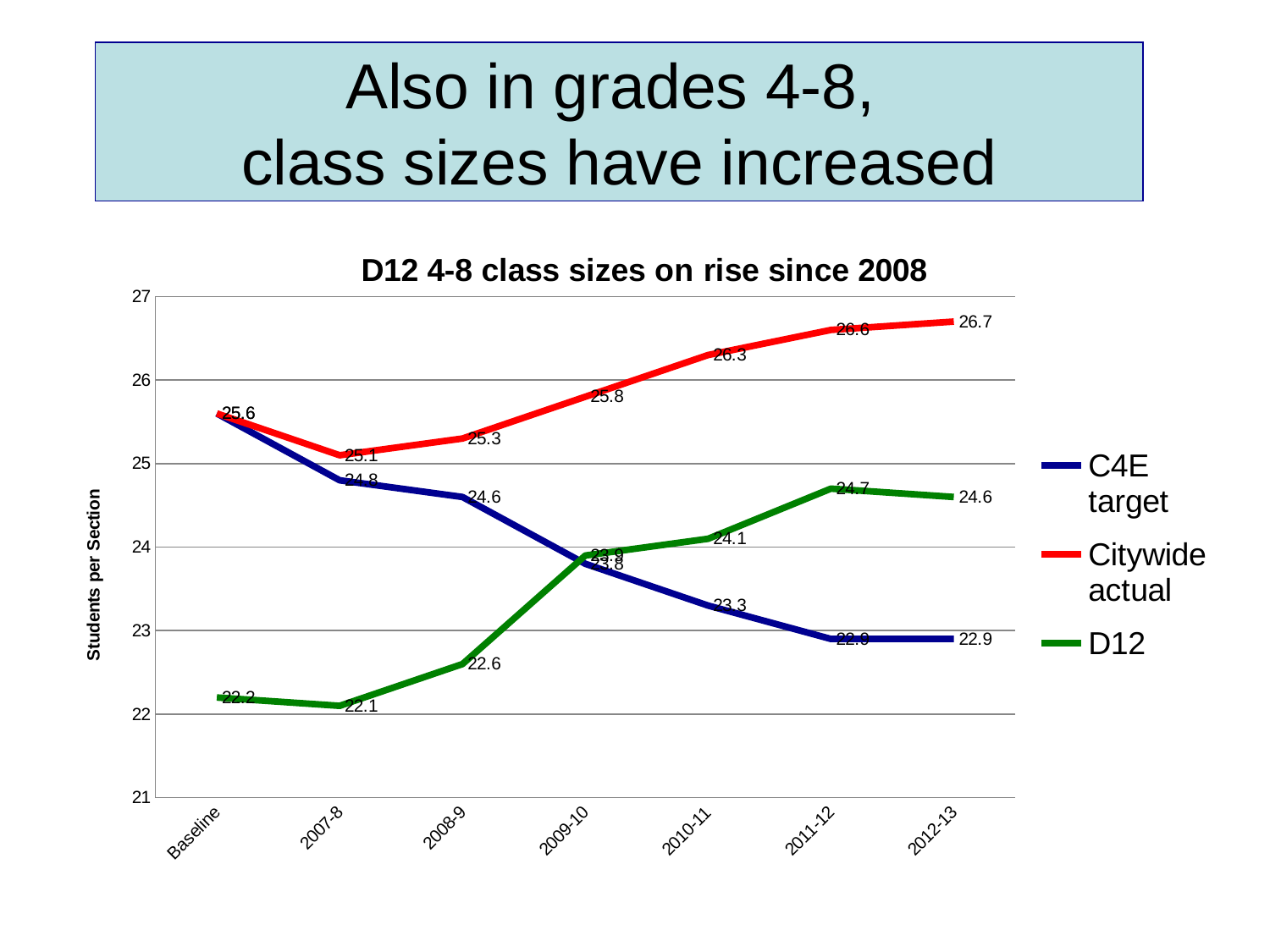
What is the Citywide actual value for 2012-13? 26.7 Does the C4E target series rise or fall from Baseline to 2012-13? fall What is the title of the chart? D12 4-8 class sizes on rise since 2008 How many points are plotted along the x axis for each series? 7 How many series does the legend list? 3 What is the C4E target value for 2012-13? 22.9 What is the difference between the Citywide actual and D12 values in 2012-13? 2.1 What is the D12 value for 2012-13? 24.6 In which year does the Citywide actual series reach its highest value? 2012-13 What kind of chart is shown on the slide? line chart In which year is the D12 series at its lowest value? 2007-8 What is the D12 value for 2007-8? 22.1